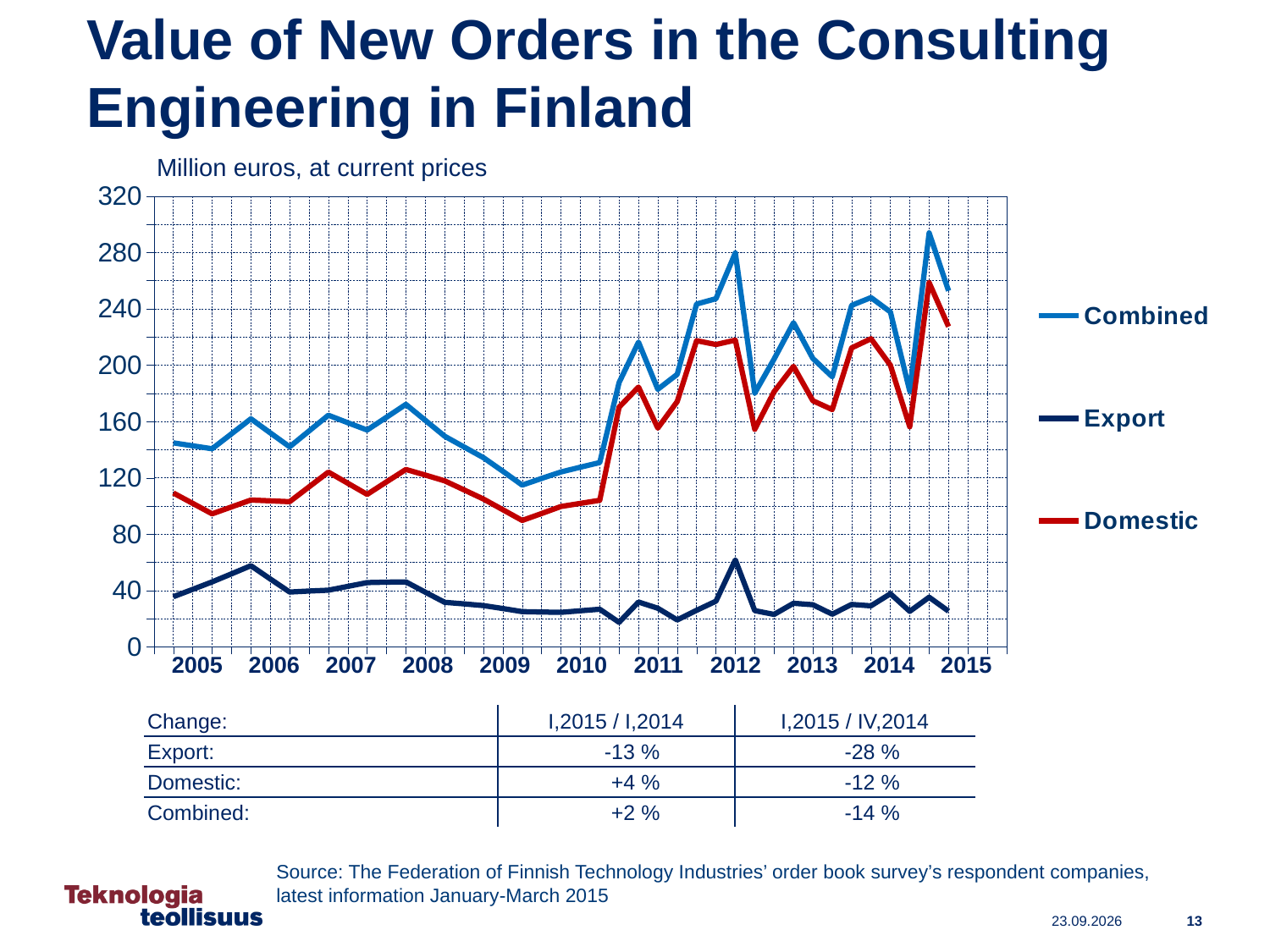
How many years are labelled on the x axis of the chart? 11 Which series has the highest values throughout the chart? Combined Does the Combined series rise or fall overall from 2005 to 2015? rise What kind of chart is shown on the slide? line chart What colour is the Domestic series line in the chart? red Is the value of the Domestic series in 2009 greater or less than 120? less Which is larger in 2013, the Domestic series or the Export series? Domestic Which series has the lowest values throughout the chart? Export Is the value of the Export series in 2012 greater or less than 80? less What unit is stated above the chart's y axis? Million euros, at current prices Is the peak value of the Combined series in 2012 greater or less than 240? greater How many series does the chart's legend list? 3